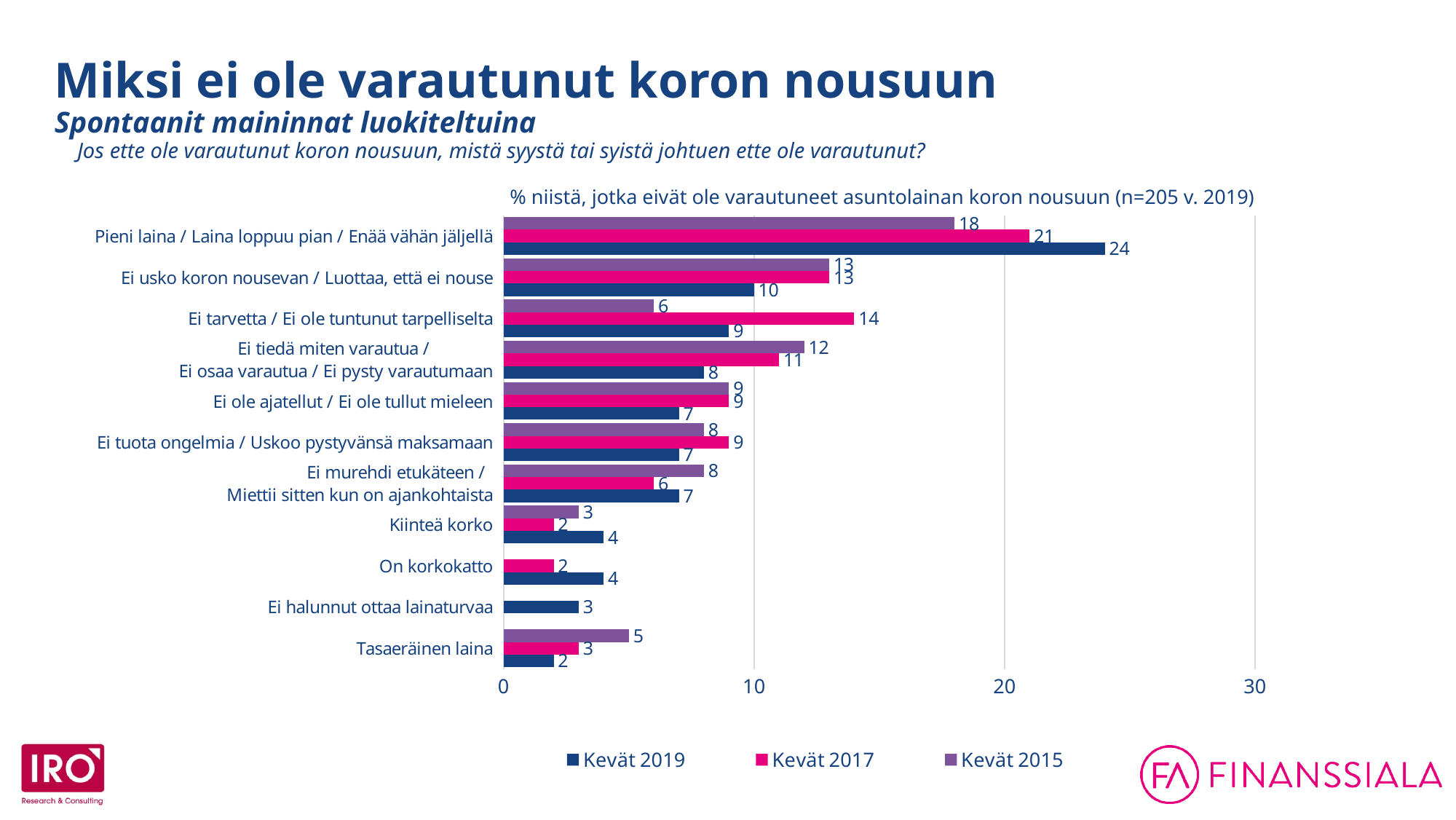
What is the difference between the Kevät 2019 and Kevät 2015 values for "Pieni laina / Laina loppuu pian / Enää vähän jäljellä"? 6 How many series does the legend list? 3 What is the Kevät 2015 value for "Tasaeräinen laina"? 5 What kind of chart is shown on the slide? Bar chart Which series is shown in pink in the legend? Kevät 2017 What is the Kevät 2019 value for "Pieni laina / Laina loppuu pian / Enää vähän jäljellä"? 24 For "Ei tiedä miten varautua / Ei osaa varautua / Ei pysty varautumaan", which is larger: the Kevät 2015 value or the Kevät 2019 value? Kevät 2015 Which category has the lowest Kevät 2019 value? Tasaeräinen laina Is the Kevät 2017 value for "Pieni laina / Laina loppuu pian / Enää vähän jäljellä" greater or less than 20? greater Which category has the highest Kevät 2019 value? Pieni laina / Laina loppuu pian / Enää vähän jäljellä What is the Kevät 2017 value for "Ei tarvetta / Ei ole tuntunut tarpelliselta"? 14 How many categories are shown on the chart? 11